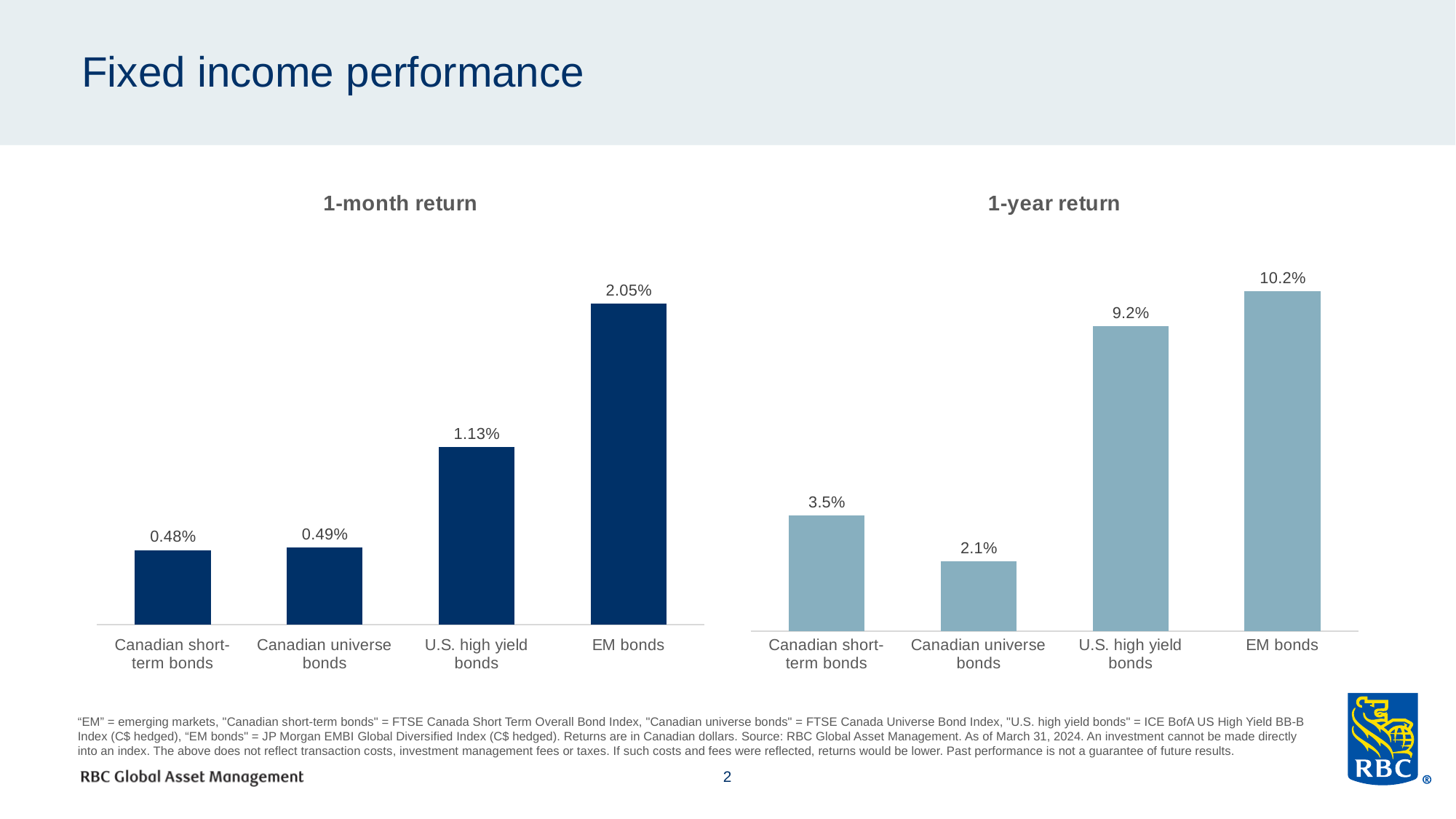
In the 1-year return chart, which category has the highest value? EM bonds In the 1-month return chart, what is the value for U.S. high yield bonds? 1.13% How many categories are shown in the 1-month return chart? 4 In the 1-month return chart, what is the value for EM bonds? 2.05% In the 1-year return chart, what is the value for Canadian universe bonds? 2.1% In the 1-year return chart, which is larger: Canadian short-term bonds or Canadian universe bonds? Canadian short-term bonds What kind of chart is the 1-year return chart? Bar chart In the 1-month return chart, which category has the highest value? EM bonds In the 1-year return chart, which category has the lowest value? Canadian universe bonds What is the title of the chart on the left side of the slide? 1-month return In the 1-year return chart, what is the difference between EM bonds and U.S. high yield bonds? 1.0% In the 1-month return chart, what is the difference between EM bonds and U.S. high yield bonds? 0.92%